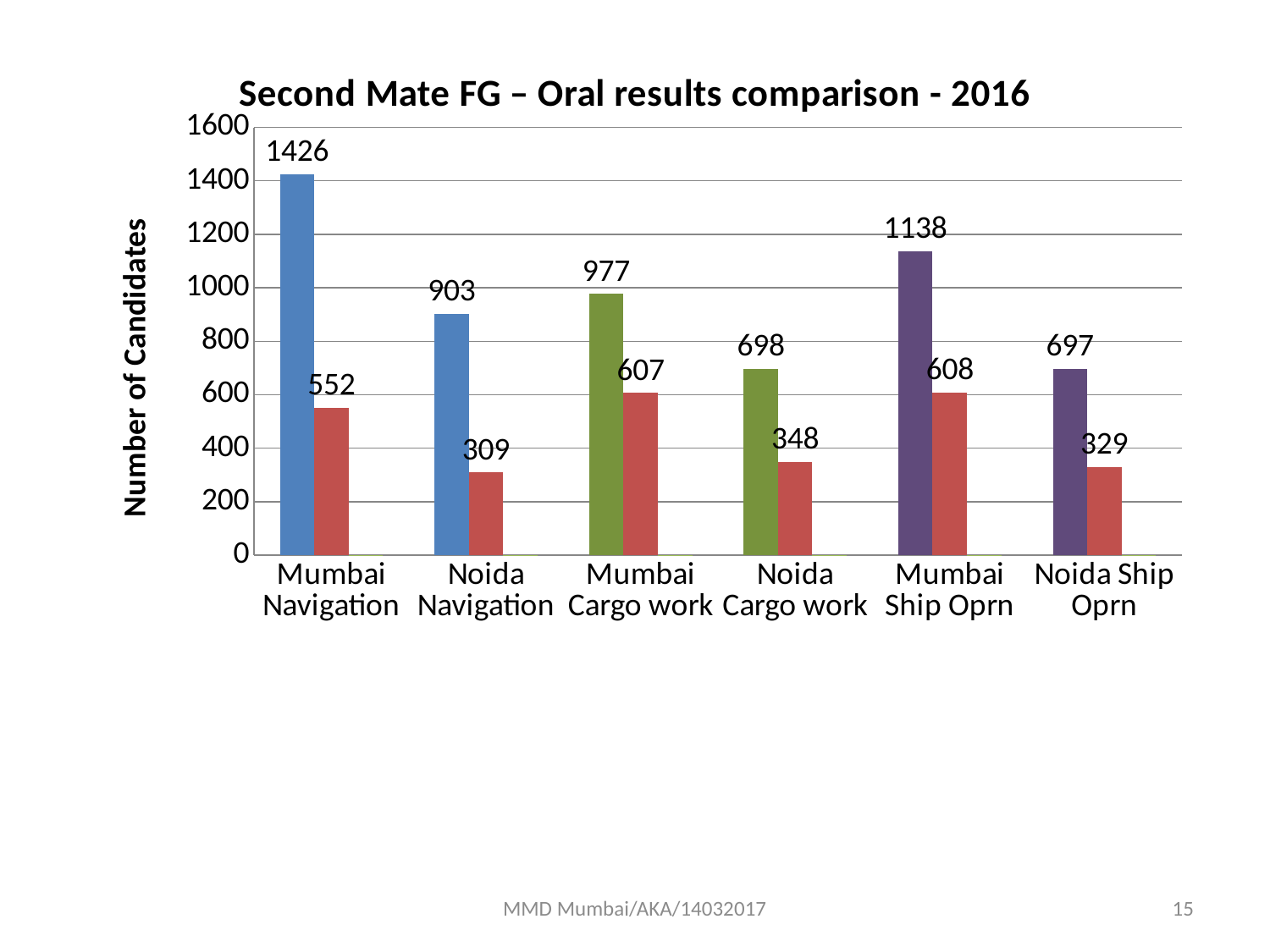
What is the value of the red bar for Noida Navigation? 309 What is the value of the red bar for Noida Ship Oprn? 329 Which is larger: the first bar for Mumbai Cargo work or the first bar for Noida Navigation? Mumbai Cargo work Which category has the lowest red bar? Noida Navigation Is the red bar for Noida Cargo work greater or less than 400? less Which category has the highest first (left) bar? Mumbai Navigation What is the difference between the two bars for Mumbai Navigation (1426 and 552)? 874 What is the title of the chart? Second Mate FG – Oral results comparison - 2016 What is the value of the first (left) bar for Mumbai Ship Oprn? 1138 What is the value of the first (left) bar for Mumbai Navigation? 1426 What is the difference between the two bars for Mumbai Ship Oprn (1138 and 608)? 530 How many categories are shown on the x axis? 6